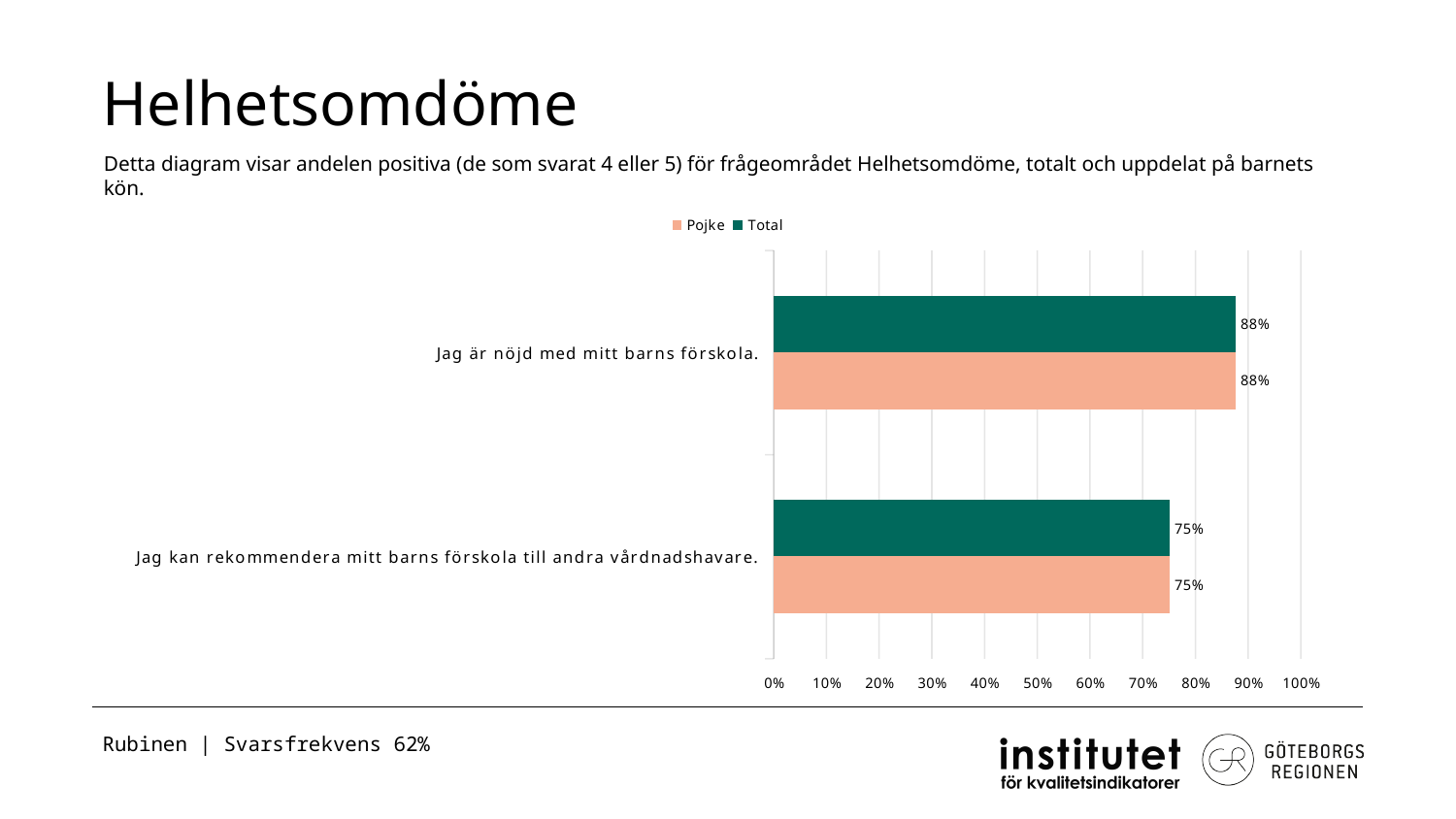
What is the Pojke value for "Jag är nöjd med mitt barns förskola."? 88% What is the Pojke value for "Jag kan rekommendera mitt barns förskola till andra vårdnadshavare."? 75% What is the difference between the Total values for "Jag är nöjd med mitt barns förskola." and "Jag kan rekommendera mitt barns förskola till andra vårdnadshavare."? 13% What kind of chart is shown on the slide? bar chart Which category has the highest Total value? Jag är nöjd med mitt barns förskola. Which is larger: the Pojke value for "Jag är nöjd med mitt barns förskola." or the Pojke value for "Jag kan rekommendera mitt barns förskola till andra vårdnadshavare."? Jag är nöjd med mitt barns förskola. Which category has the lowest Pojke value? Jag kan rekommendera mitt barns förskola till andra vårdnadshavare. Is the Total value for "Jag kan rekommendera mitt barns förskola till andra vårdnadshavare." greater or less than 80%? less How many categories are shown in the chart? 2 What is the Total value for "Jag kan rekommendera mitt barns förskola till andra vårdnadshavare."? 75% How many series does the legend list? 2 What is the Total value for "Jag är nöjd med mitt barns förskola."? 88%